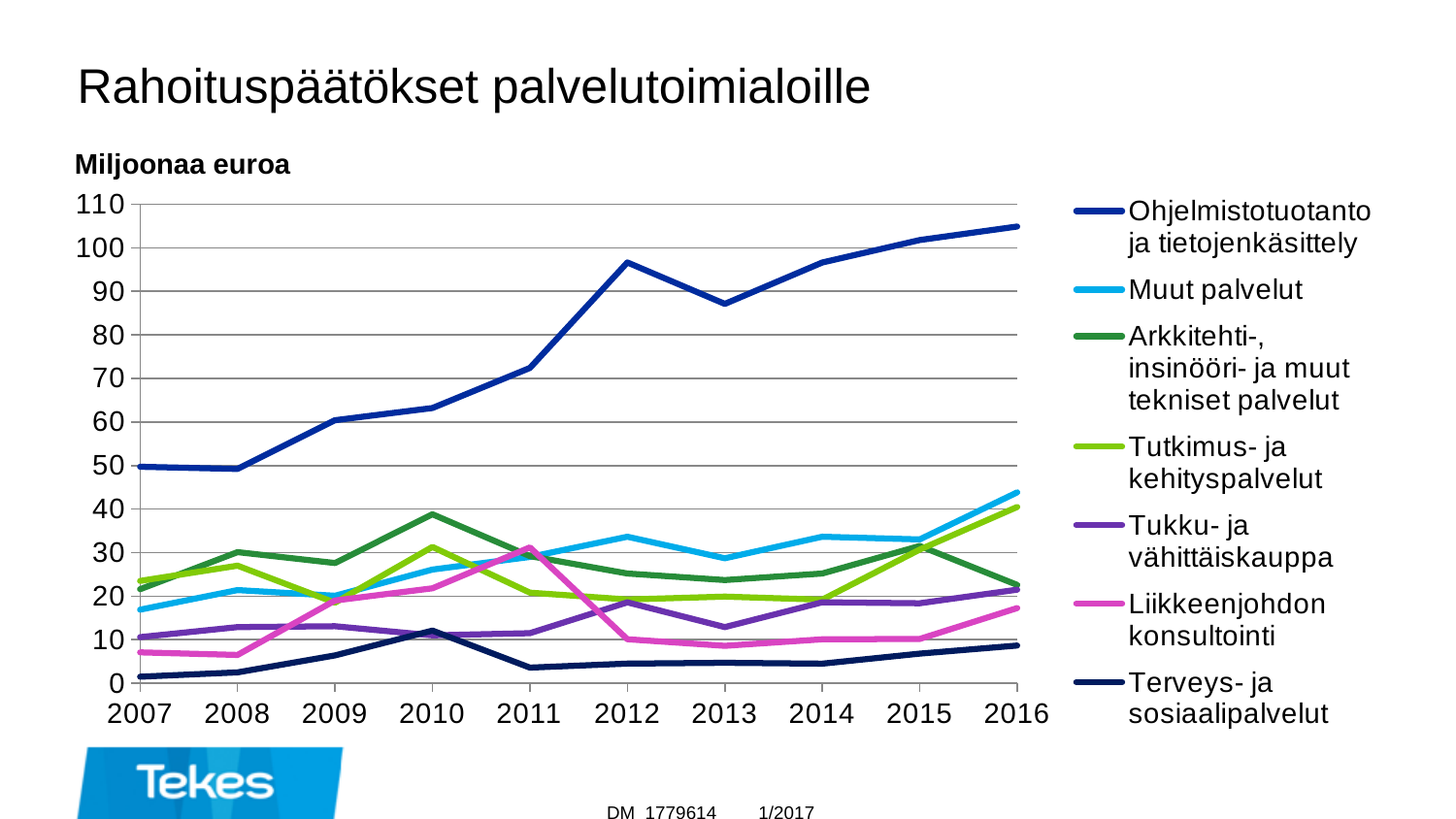
In 2016, which is larger: Muut palvelut or Tutkimus- ja kehityspalvelut? Muut palvelut Does the Ohjelmistotuotanto ja tietojenkäsittely line rise or fall between 2012 and 2013? fall Is the value for Ohjelmistotuotanto ja tietojenkäsittely in 2012 greater or less than 90? greater How many series does the legend list? 7 In which year does Liikkeenjohdon konsultointi reach its highest value? 2011 How many years are shown on the x axis? 10 Is the value for Ohjelmistotuotanto ja tietojenkäsittely in 2016 greater or less than 100? greater What unit is stated above the chart? Miljoonaa euroa Which series has the highest value in 2016? Ohjelmistotuotanto ja tietojenkäsittely Which series has the lowest value in 2007? Terveys- ja sosiaalipalvelut Is the value for Arkkitehti-, insinööri- ja muut tekniset palvelut in 2010 greater or less than 30? greater What type of chart is shown on the slide? line chart